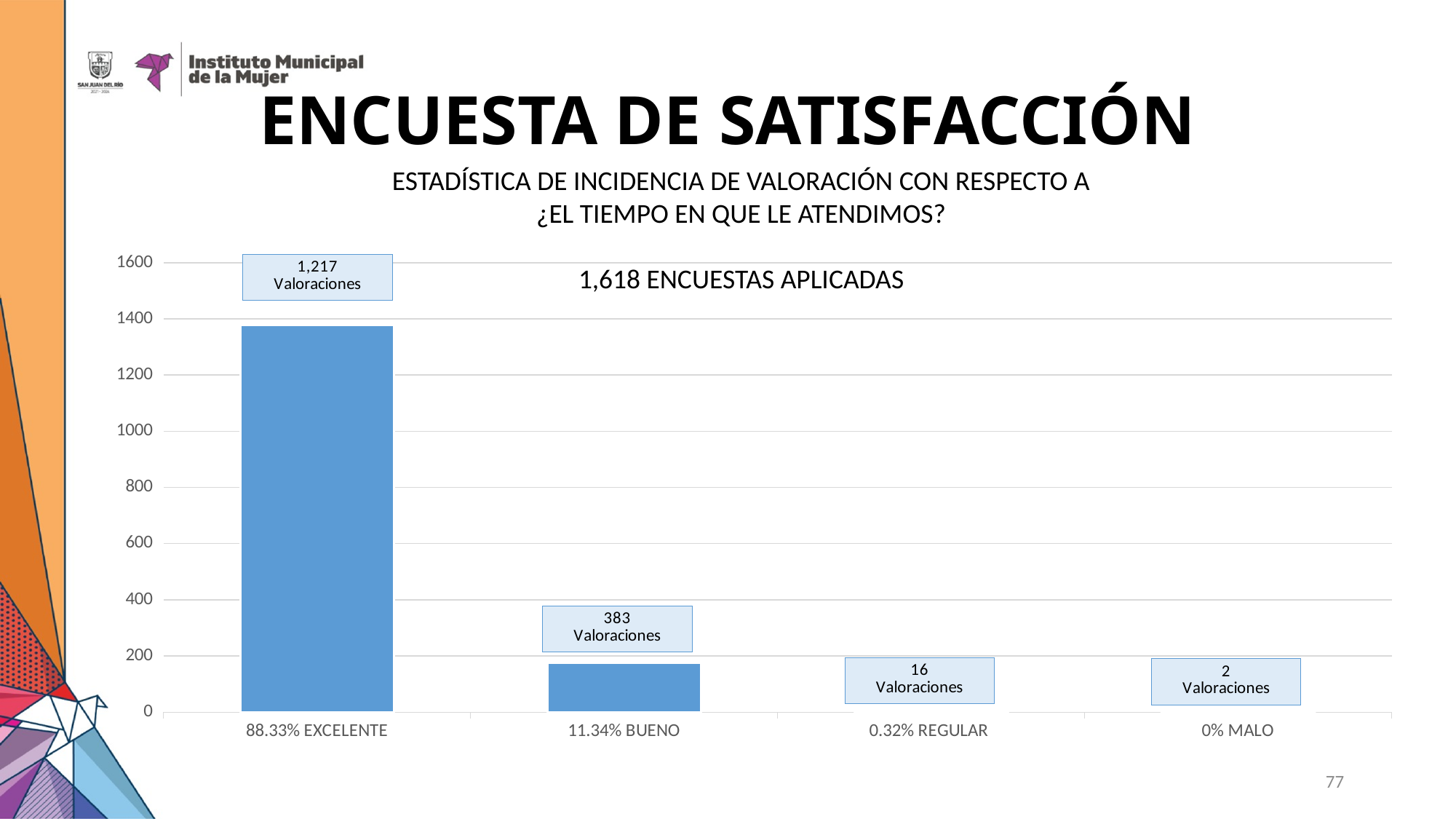
What is the difference between the labeled values for 11.34% BUENO and 0.32% REGULAR? 367 How many categories are shown on the x axis of the chart? 4 According to its data label, how many valoraciones does the 0% MALO category have? 2 Valoraciones According to its data label, how many valoraciones does the 0.32% REGULAR category have? 16 Valoraciones Which is larger, the value for 11.34% BUENO or the value for 0.32% REGULAR? 11.34% BUENO According to its data label, how many valoraciones does the 11.34% BUENO category have? 383 Valoraciones Which category has the highest bar in the chart? 88.33% EXCELENTE Is the bar for 88.33% EXCELENTE greater or less than 1200? greater According to its data label, how many valoraciones does the 88.33% EXCELENTE category have? 1,217 Valoraciones What kind of chart is shown on the slide? Bar chart Which category has the lowest value in the chart? 0% MALO How many encuestas aplicadas does the chart report in total? 1,618